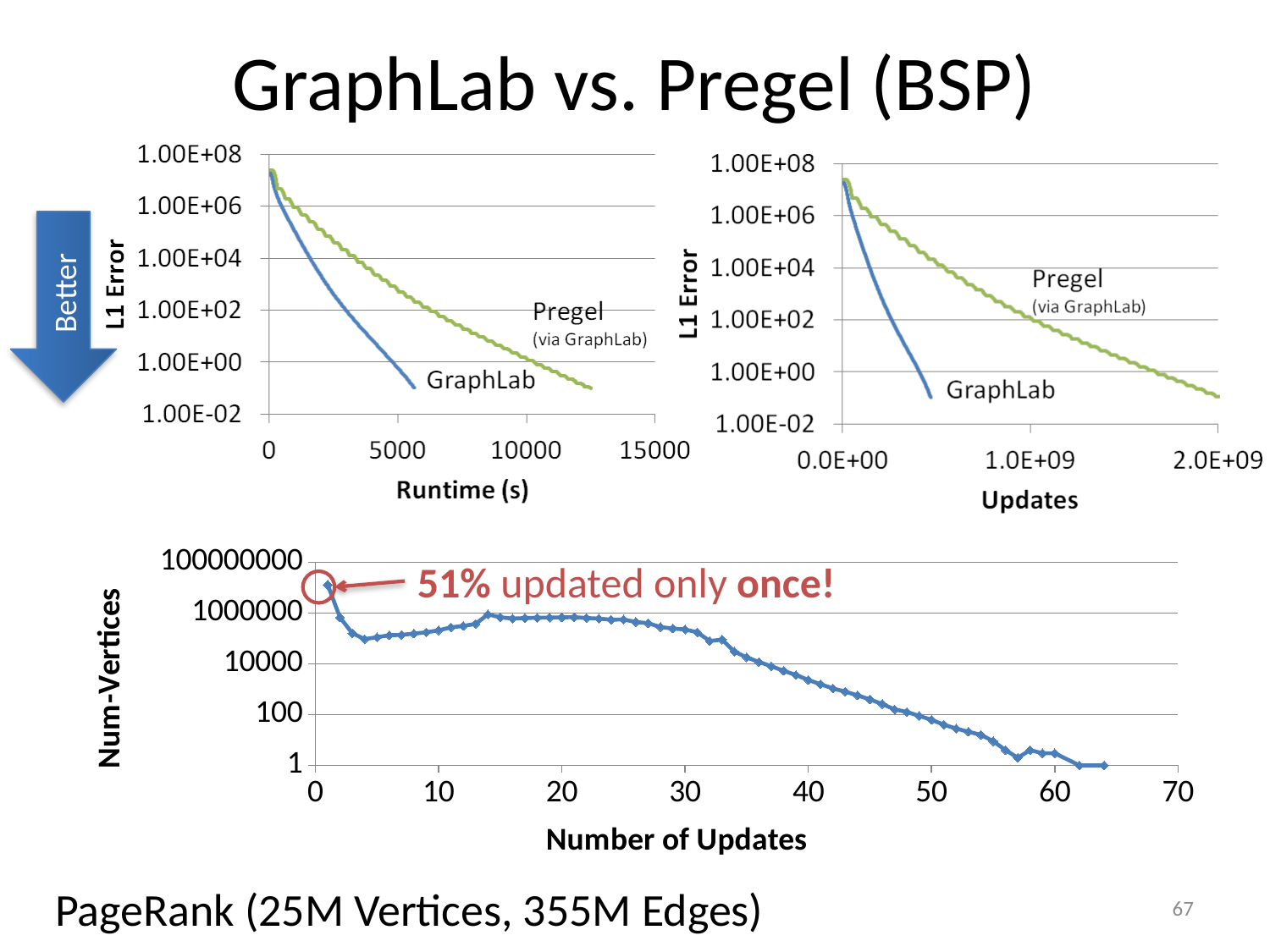
In the top-left chart (L1 Error vs Runtime), is the runtime at which the GraphLab line ends greater or less than 10000 seconds? less In the top-left chart (L1 Error vs Runtime), which series reaches an L1 Error of 1.00E+00 at a shorter runtime, GraphLab or Pregel? GraphLab What kind of chart is the top-left chart with the x axis labelled Runtime (s)? line chart In the bottom chart (Num-Vertices vs Number of Updates), is the Num-Vertices value at 1 update greater or less than 1000000? greater What does the red annotation on the bottom chart say? 51% updated only once! In the top-right chart (L1 Error vs Updates), is the number of updates at which the GraphLab line ends greater or less than 1.0E+09? less What is the x-axis label of the top-right chart? Updates In the top-right chart (L1 Error vs Updates), which series needs more updates to reach an L1 Error of 1.00E+00, GraphLab or Pregel? Pregel In the top-left chart, does L1 Error rise or fall as Runtime increases? fall In the top-left chart (L1 Error vs Runtime), how many series are plotted? 2